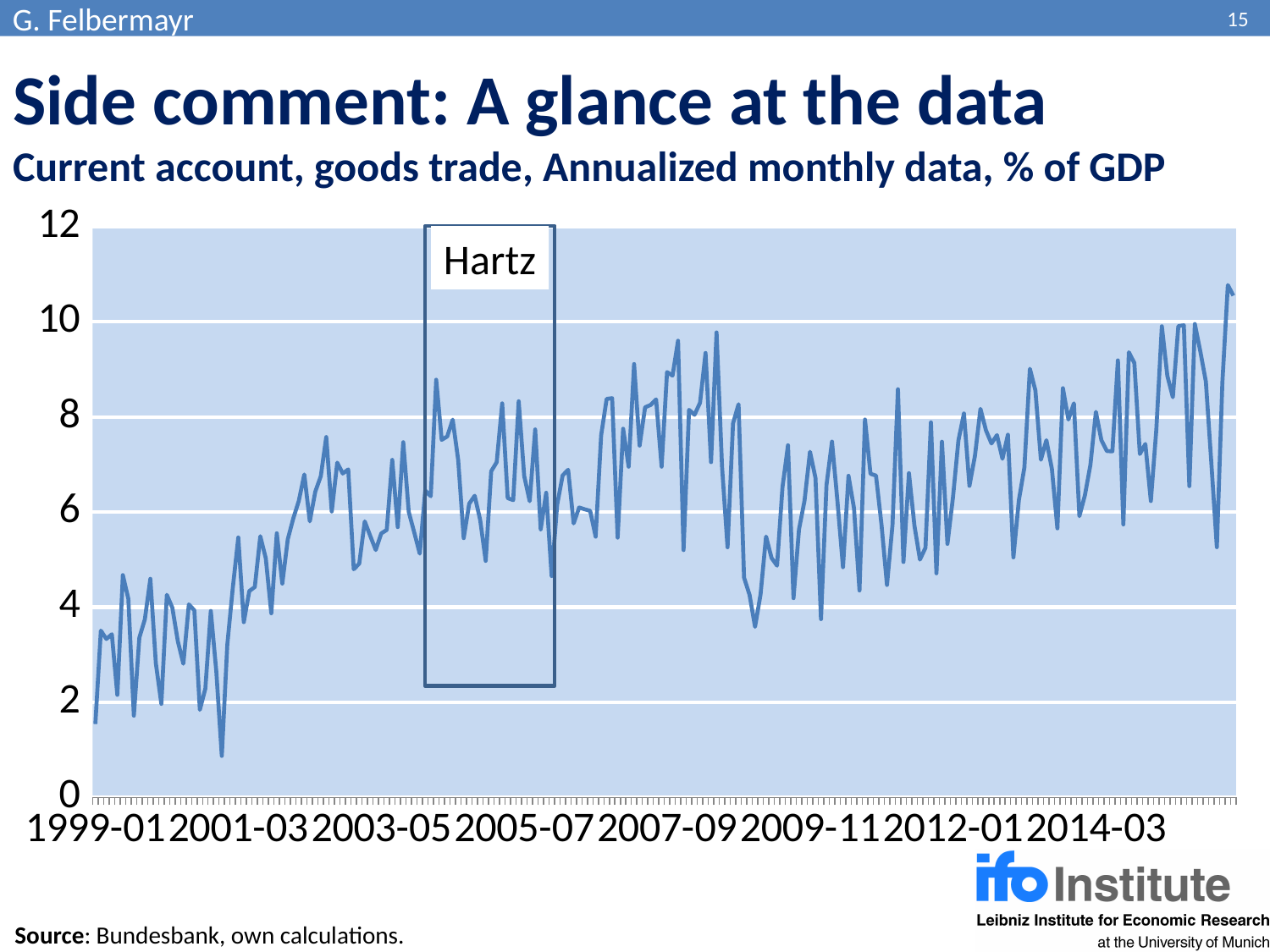
Overall, do the values rise or fall from 1999-01 to the end of the series? rise Is the lowest value on the chart greater or less than 2? less What is the title of the chart on the slide? Current account, goods trade, Annualized monthly data, % of GDP How many date labels are printed on the x axis? 8 What kind of chart is shown on the slide? line chart How many lines are plotted on the chart? 1 Is the value at 1999-01 greater or less than 2? less What is the highest value shown on the y axis? 12 Is the highest value on the chart greater or less than 10? greater Which is larger, the value at the first point (1999-01) or the value at the last point of the series? the last point What label appears in the box drawn over the chart? Hartz